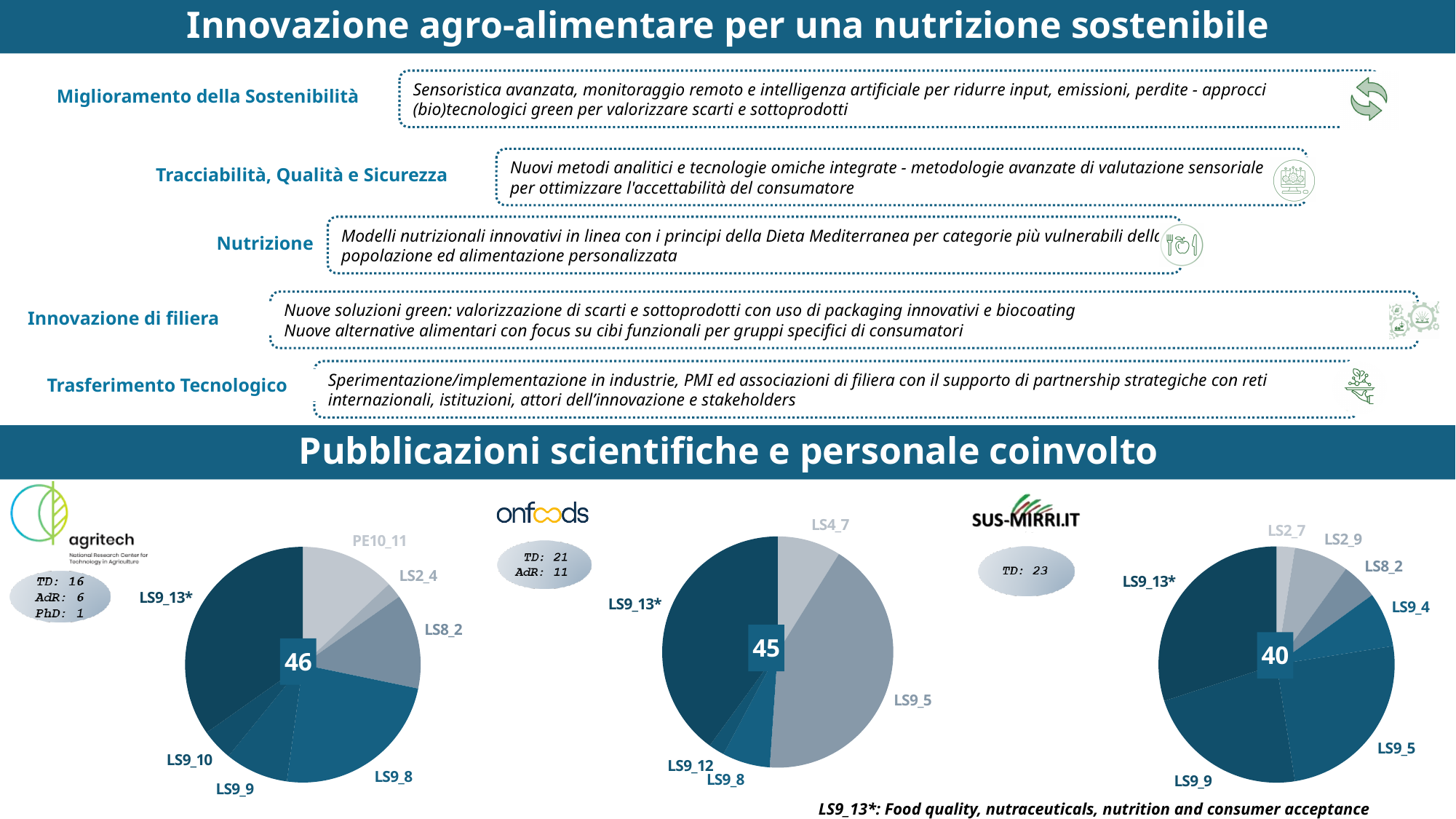
In the SUS-MIRRI.IT pie chart (right), which slice is larger, LS9_5 or LS2_7? LS9_5 In the onfoods pie chart (middle), which slice is the largest? LS9_5 According to the footnote, what does LS9_13* stand for? Food quality, nutraceuticals, nutrition and consumer acceptance How many slices does the agritech pie chart (left) have? 7 In the agritech pie chart (left), what number is printed at the centre of the pie? 46 How many slices does the SUS-MIRRI.IT pie chart (right) have? 7 In the agritech pie chart (left), which slice is larger, LS9_13* or LS2_4? LS9_13* How many slices does the onfoods pie chart (middle) have? 5 In the onfoods pie chart (middle), what number is printed at the centre of the pie? 45 In the SUS-MIRRI.IT pie chart (right), what number is printed at the centre of the pie? 40 What type of chart is used under 'Pubblicazioni scientifiche e personale coinvolto'? Pie chart